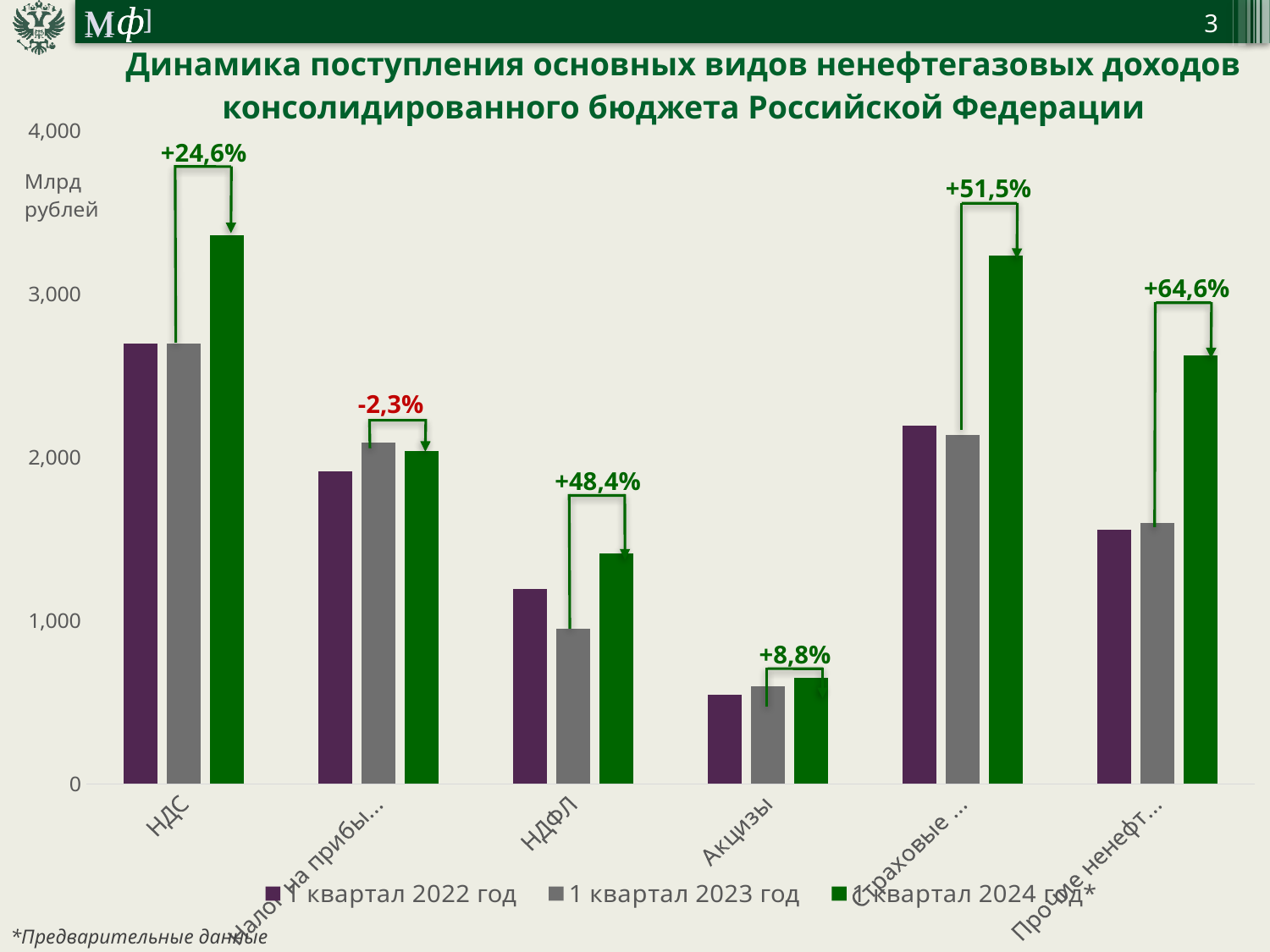
Which is larger for 1 квартал 2022 год: НДС or НДФЛ? НДС What type of chart is shown on the slide? bar chart Which category has the lowest values across all three series? Акцизы Is the value for НДС in 1 квартал 2024 год greater or less than 3,000? greater How many series does the legend list? 3 What percentage change is labelled above the НДС bars? +24,6% Which category has the only negative percentage change label, and what is it? Налог на прибыль, -2,3% Is the value for НДФЛ in 1 квартал 2023 год greater or less than 1,000? less Which category has the highest value for 1 квартал 2024 год? НДС What percentage change is labelled above the Акцизы bars? +8,8% How many categories are shown on the x axis? 6 What percentage change is labelled above the НДФЛ bars? +48,4%